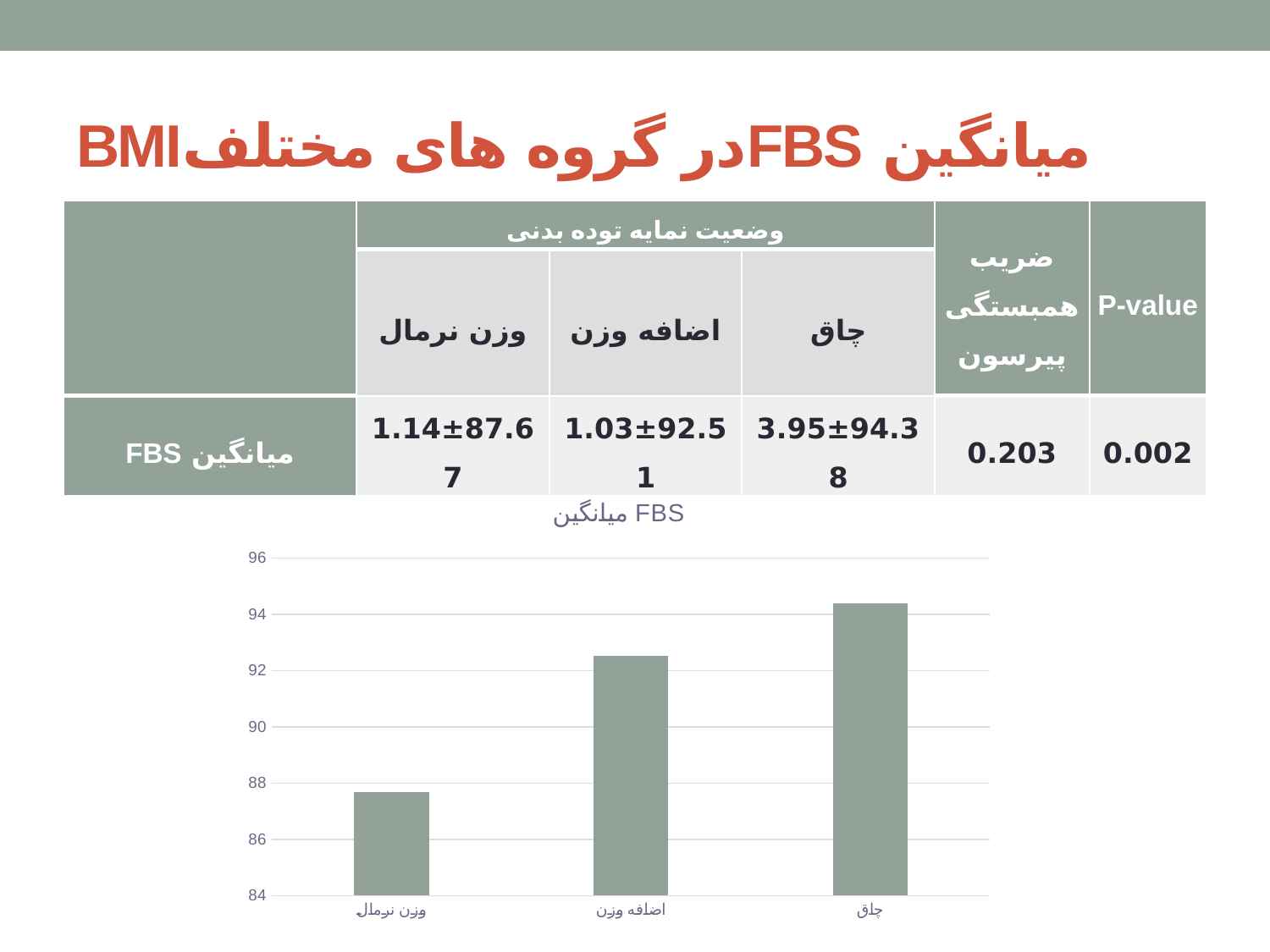
What is the title of the chart? میانگین FBS How many categories (bars) does the chart show? 3 Which category has the lowest bar in the chart? وزن نرمال According to the table above the chart, what is the mean FBS for the چاق group? 94.38 Is the value for اضافه وزن greater or less than 92? greater Which category has the highest bar in the chart? چاق Do the bar values rise or fall from left to right along the x axis? rise Is the value for چاق greater or less than 94? greater What kind of chart is shown on the slide? bar chart What is the highest tick value shown on the chart's vertical axis? 96 Which is larger, the bar for اضافه وزن or the bar for وزن نرمال? اضافه وزن Is the value for وزن نرمال greater or less than 88? less